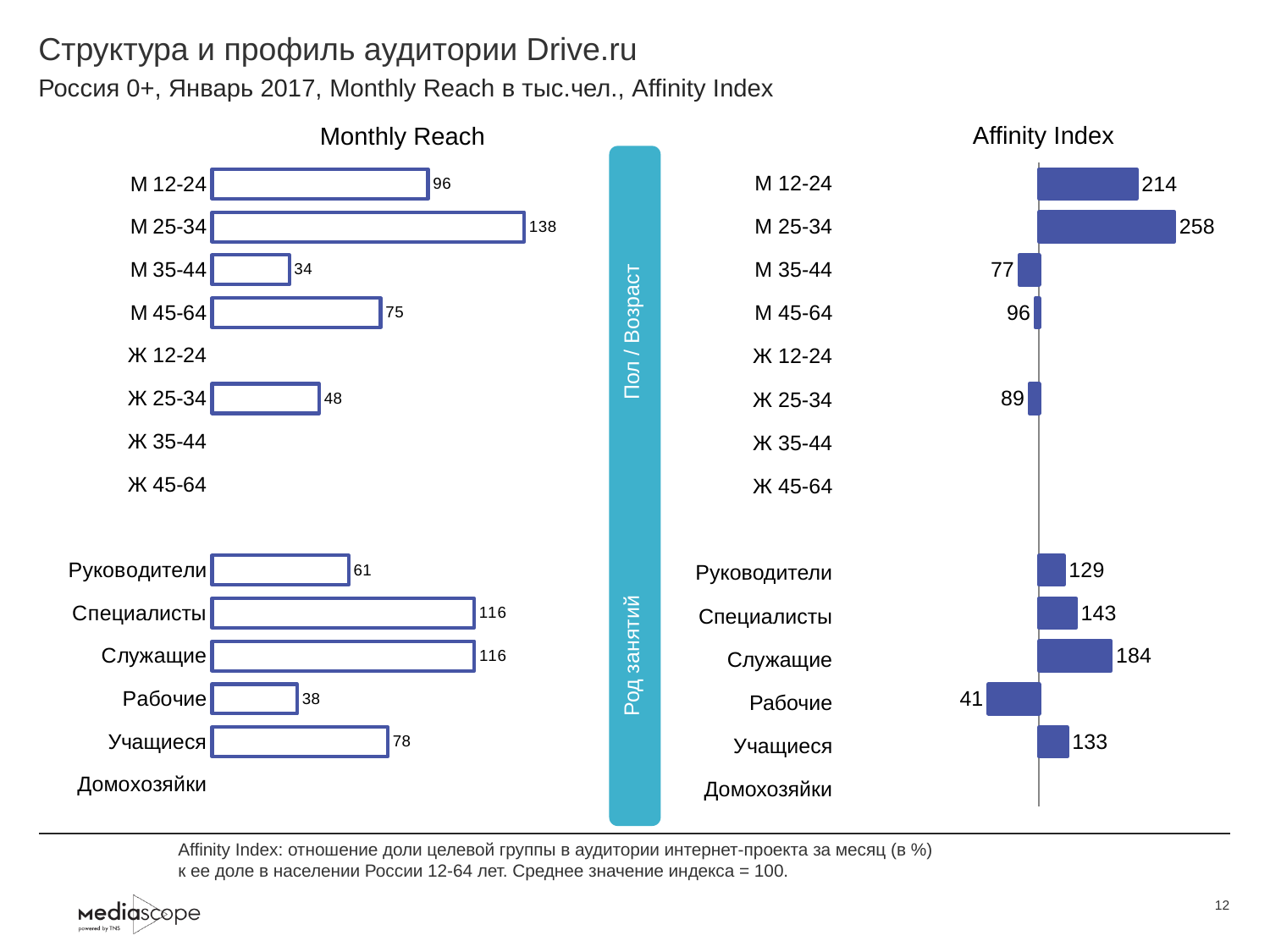
In the Monthly Reach chart, which category has the highest value? М 25-34 In the Affinity Index chart, what is the value for Служащие? 184 In the Affinity Index chart, what is the value for М 45-64? 96 In the Monthly Reach chart, what is the value for Рабочие? 38 In the Affinity Index chart, which is larger: the value for Специалисты or the value for Руководители? Специалисты In the Affinity Index chart, which category has the lowest value? Рабочие In the Monthly Reach chart, what is the value for М 25-34? 138 In the Monthly Reach chart, what is the value for Специалисты? 116 What kind of chart is the Monthly Reach chart? Bar chart In the Affinity Index chart, what is the difference between the values for М 25-34 and М 12-24? 44 In the Monthly Reach chart, what is the difference between the values for М 25-34 and М 12-24? 42 In the Monthly Reach chart, which is larger: the value for Учащиеся or the value for Рабочие? Учащиеся